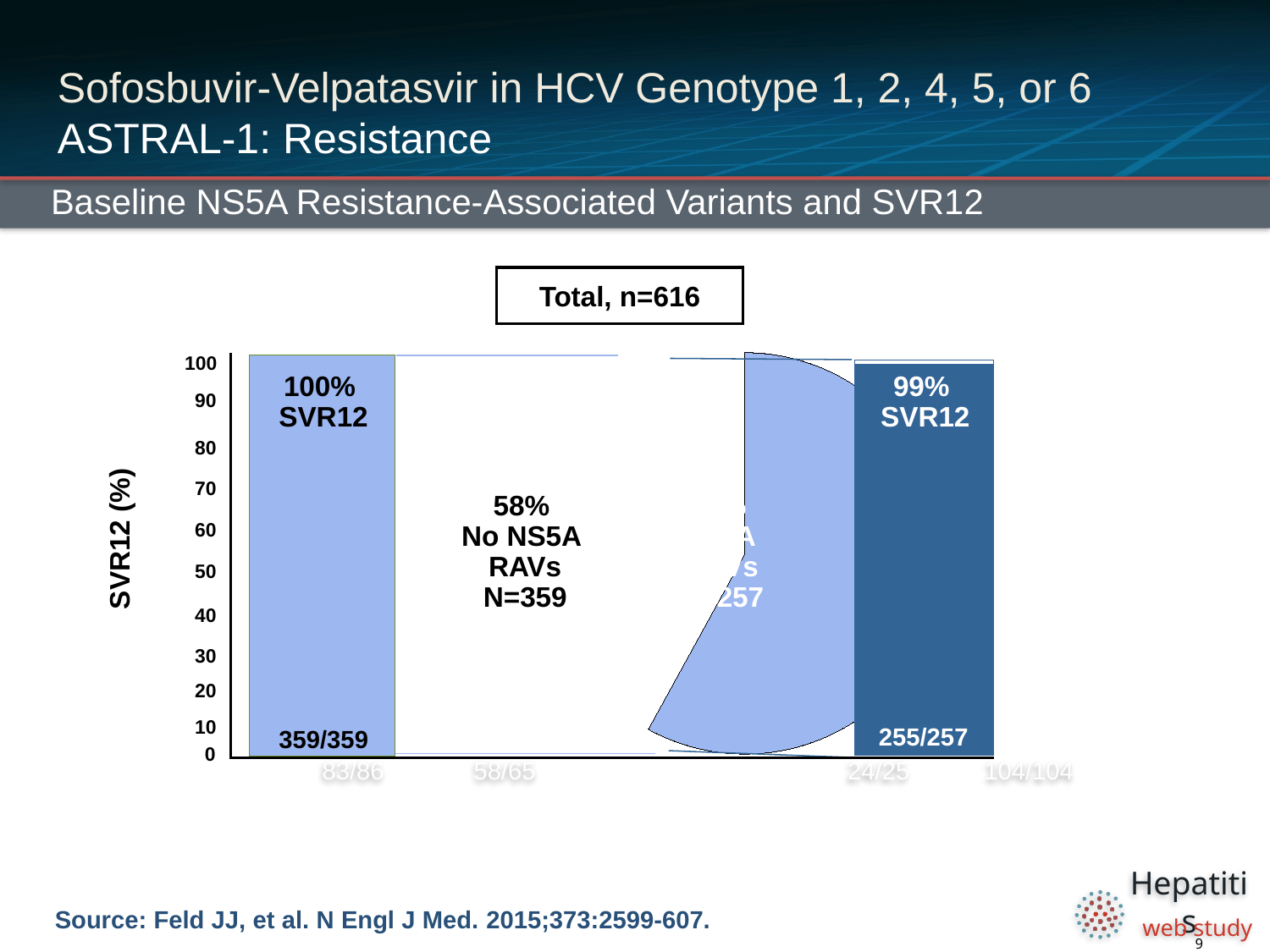
What share of the pie chart is labelled 'No NS5A RAVs'? 58% What is the difference in SVR12 between the left bar (100%) and the right bar (99%)? 1 percentage point How many bars are plotted in the SVR12 bar chart? 2 What SVR12 percentage is shown on the left (light blue) bar? 100% What fraction of patients is printed at the bottom of the left bar? 359/359 What is the N printed for the 'No NS5A RAVs' slice of the pie chart? N=359 What kind of chart is used to show the SVR12 values? Bar chart Is the SVR12 value for the right bar greater or less than 90? greater What total number of patients is shown in the box above the chart? Total, n=616 What fraction of patients is printed at the bottom of the right bar? 255/257 What SVR12 percentage is shown on the right (dark blue) bar? 99% Which bar shows the higher SVR12, the left bar or the right bar? The left bar (100%)